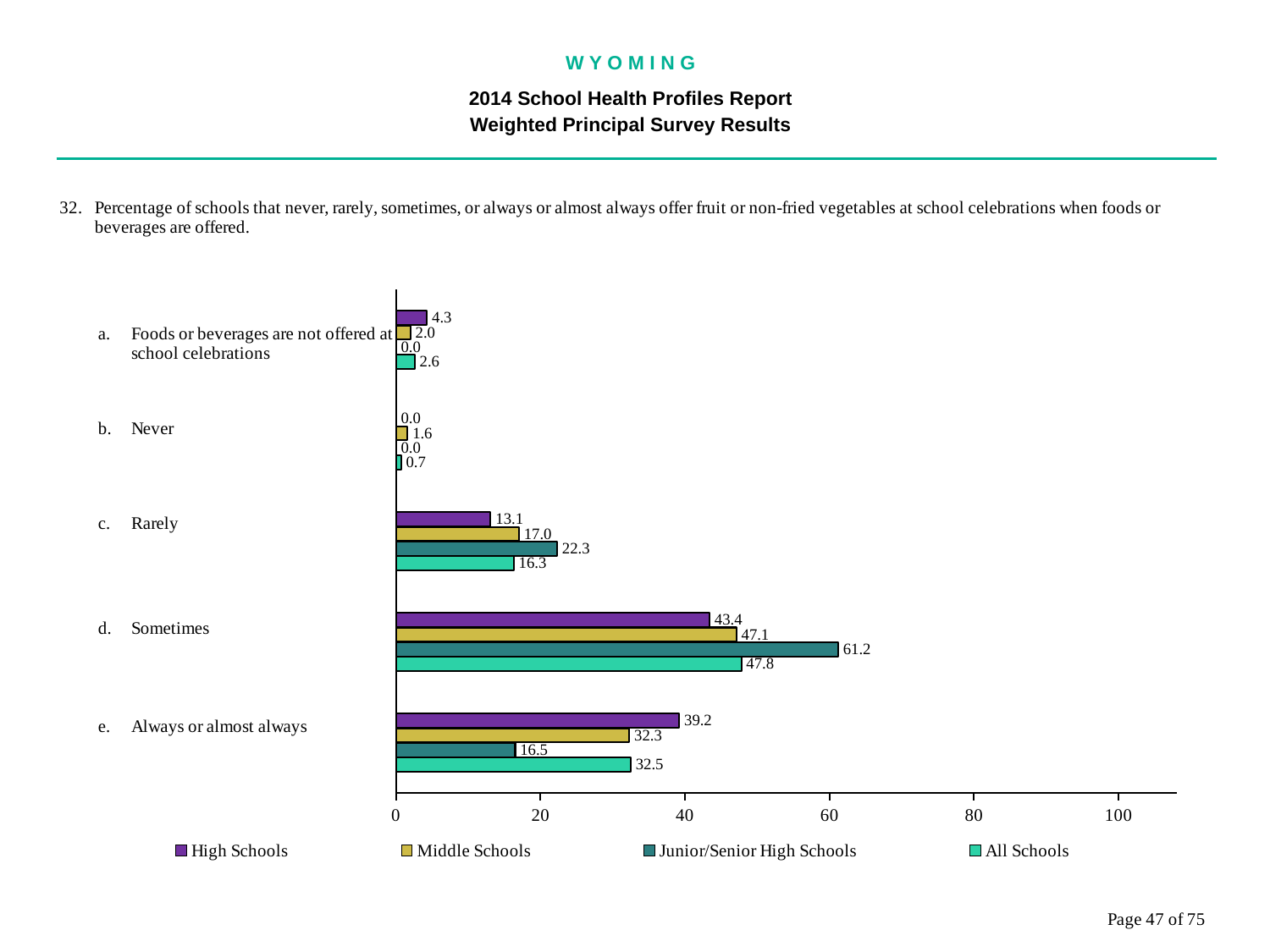
What is the difference between the Junior/Senior High Schools and High Schools values in the Sometimes category? 17.8 What is the value for Junior/Senior High Schools in the Sometimes category? 61.2 What is the value for High Schools in the Always or almost always category? 39.2 What is the value for All Schools in the Rarely category? 16.3 What is the value for Middle Schools in the Never category? 1.6 How many series does the legend list? 4 Which category has the lowest value for Middle Schools? Never Which category has the highest value for All Schools? Sometimes What kind of chart is shown on the slide? Bar chart Is the value for Junior/Senior High Schools in the Sometimes category greater or less than 60? greater How many categories are shown on the chart? 5 In the Always or almost always category, which is larger: High Schools or Junior/Senior High Schools? High Schools